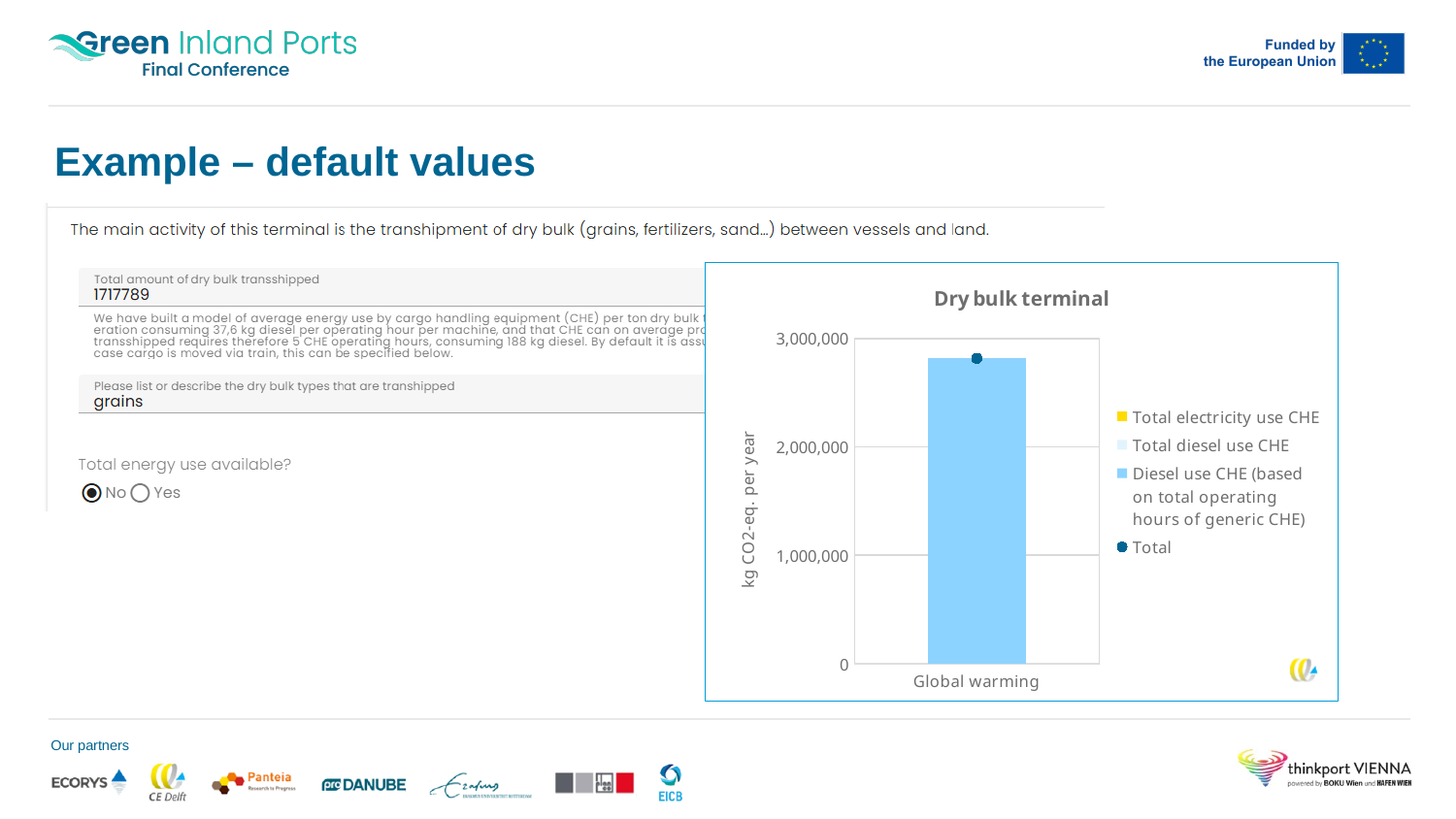
How many categories are shown on the x axis of the chart? 1 Is the value of the bar for Global warming greater or less than 2,000,000? greater What is the title of the chart? Dry bulk terminal Is the value of the bar for Global warming greater or less than 3,000,000? less What is the highest value shown on the y axis of the chart? 3,000,000 What is the y-axis label of the chart? kg CO2-eq. per year What type of chart is shown on the slide? bar chart What is the category label on the x axis of the chart? Global warming How many entries does the chart's legend list? 4 Is the Total marker for Global warming greater or less than 1,000,000? greater